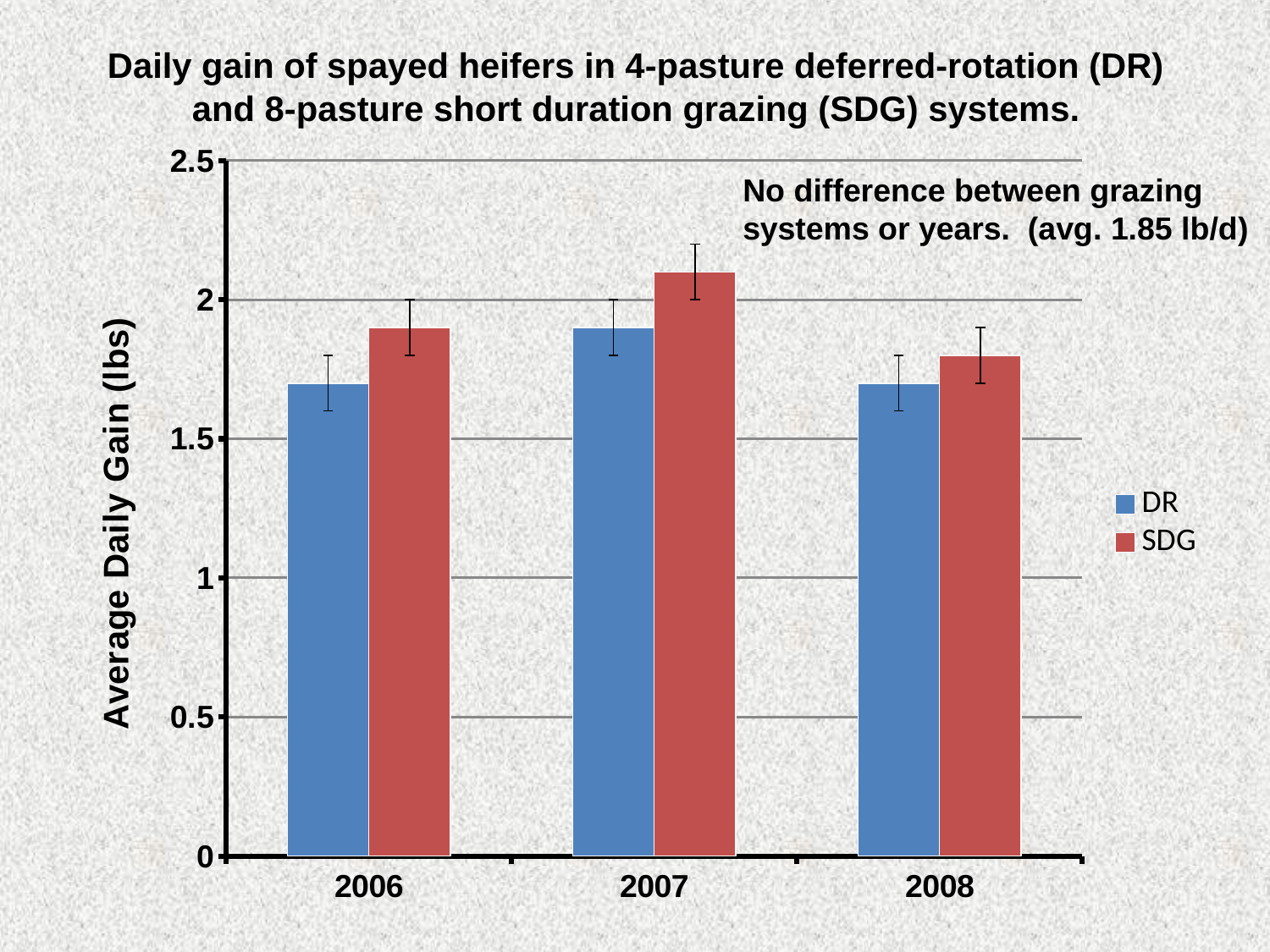
How many years are shown on the x axis? 3 In 2006, which is larger, DR or SDG? SDG How many series does the legend list? 2 What kind of chart is shown on the slide? bar chart In 2007, which is larger, DR or SDG? SDG Is the value for DR in 2008 greater or less than 1.5? greater What is the label on the y axis? Average Daily Gain (lbs) What average daily gain is stated in the annotation on the chart? 1.85 lb/d Which is larger for DR, 2006 or 2007? 2007 Is the value for DR in 2006 greater or less than 2? less Is the value for SDG in 2007 greater or less than 2? greater Which bar is the highest in the chart? SDG in 2007